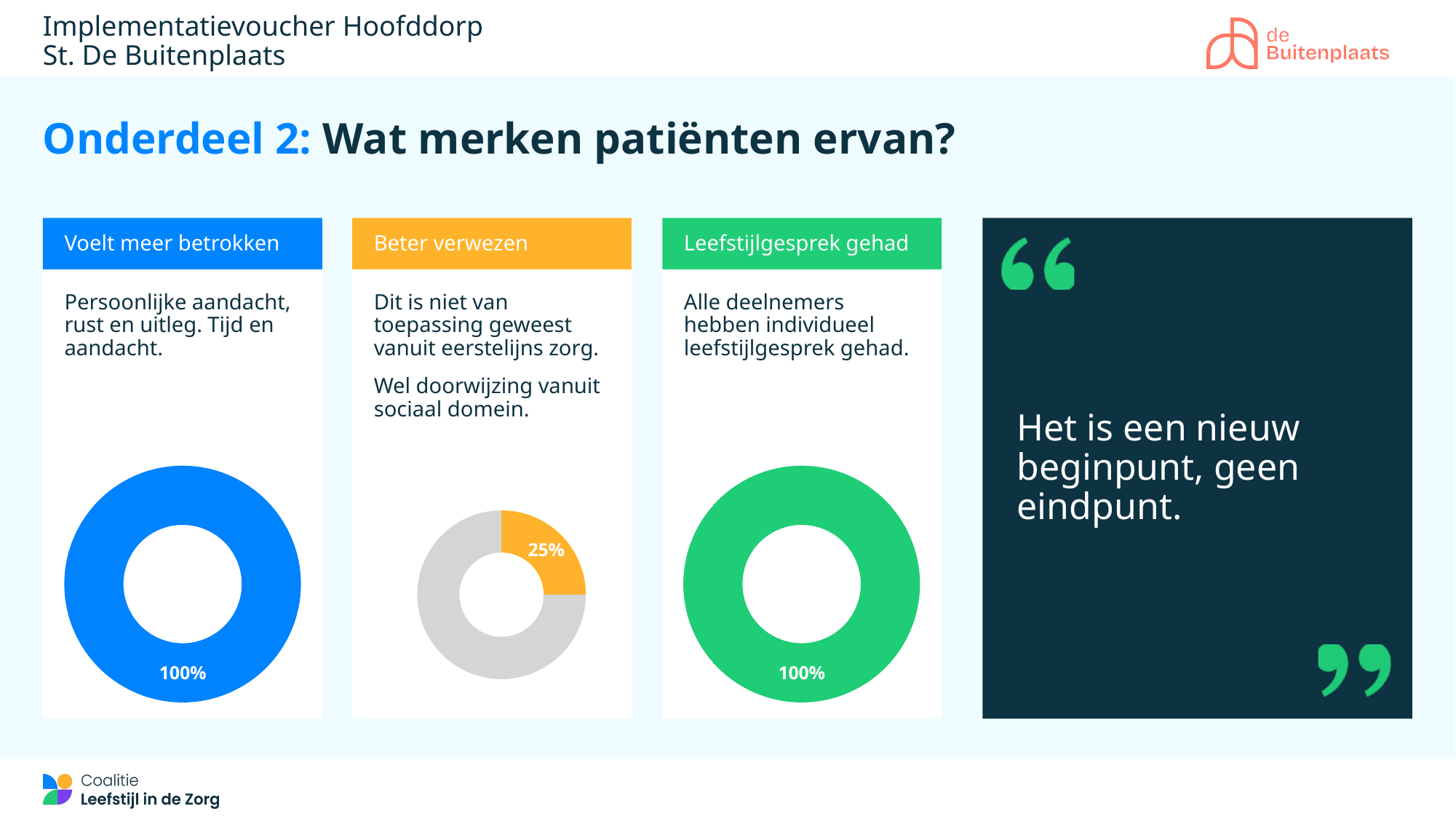
What colour is the filled ring in the 'Voelt meer betrokken' donut chart? Blue Which is larger: the percentage in the 'Beter verwezen' chart or the percentage in the 'Leefstijlgesprek gehad' chart? Leefstijlgesprek gehad What percentage is shown in the 'Voelt meer betrokken' donut chart? 100% In the 'Beter verwezen' donut chart, what share of the ring is coloured orange? 25% Is the percentage in the 'Beter verwezen' donut chart greater or less than 50%? less What is the difference between the percentage in the 'Voelt meer betrokken' chart and the percentage in the 'Beter verwezen' chart? 75% Which of the three donut charts shows the lowest percentage? Beter verwezen What percentage is shown in the 'Leefstijlgesprek gehad' donut chart? 100% How many donut charts are shown on the slide? 3 What percentage is shown in the 'Beter verwezen' donut chart? 25% What colour is the filled ring in the 'Leefstijlgesprek gehad' donut chart? Green What type of chart is used in the 'Beter verwezen' panel? Donut chart